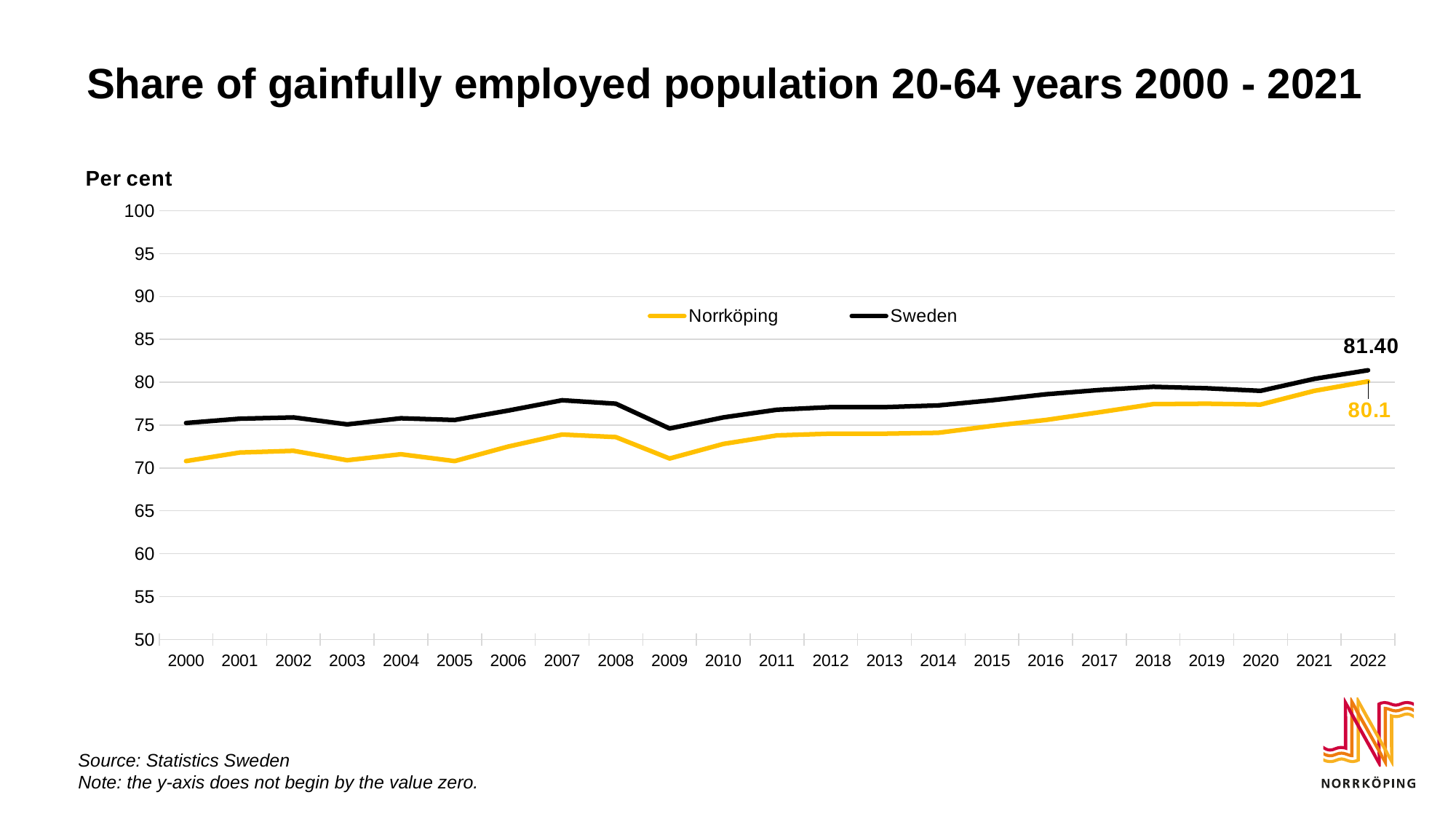
How many series does the legend list? 2 What is the title of the chart? Share of gainfully employed population 20-64 years 2000 - 2021 Overall, do the values for Norrköping rise or fall from 2000 to 2022? rise Is the value for Norrköping in 2000 greater or less than 75? less What is the value for Norrköping in 2022? 80.1 What is the value for Sweden in 2022? 81.40 How many years are shown on the x axis? 23 Is the value for Norrköping in 2009 greater or less than 75? less Which series has the higher value in 2022, Norrköping or Sweden? Sweden What kind of chart is shown on the slide? line chart Is the value for Sweden in 2007 greater or less than 75? greater Which series is drawn in yellow? Norrköping